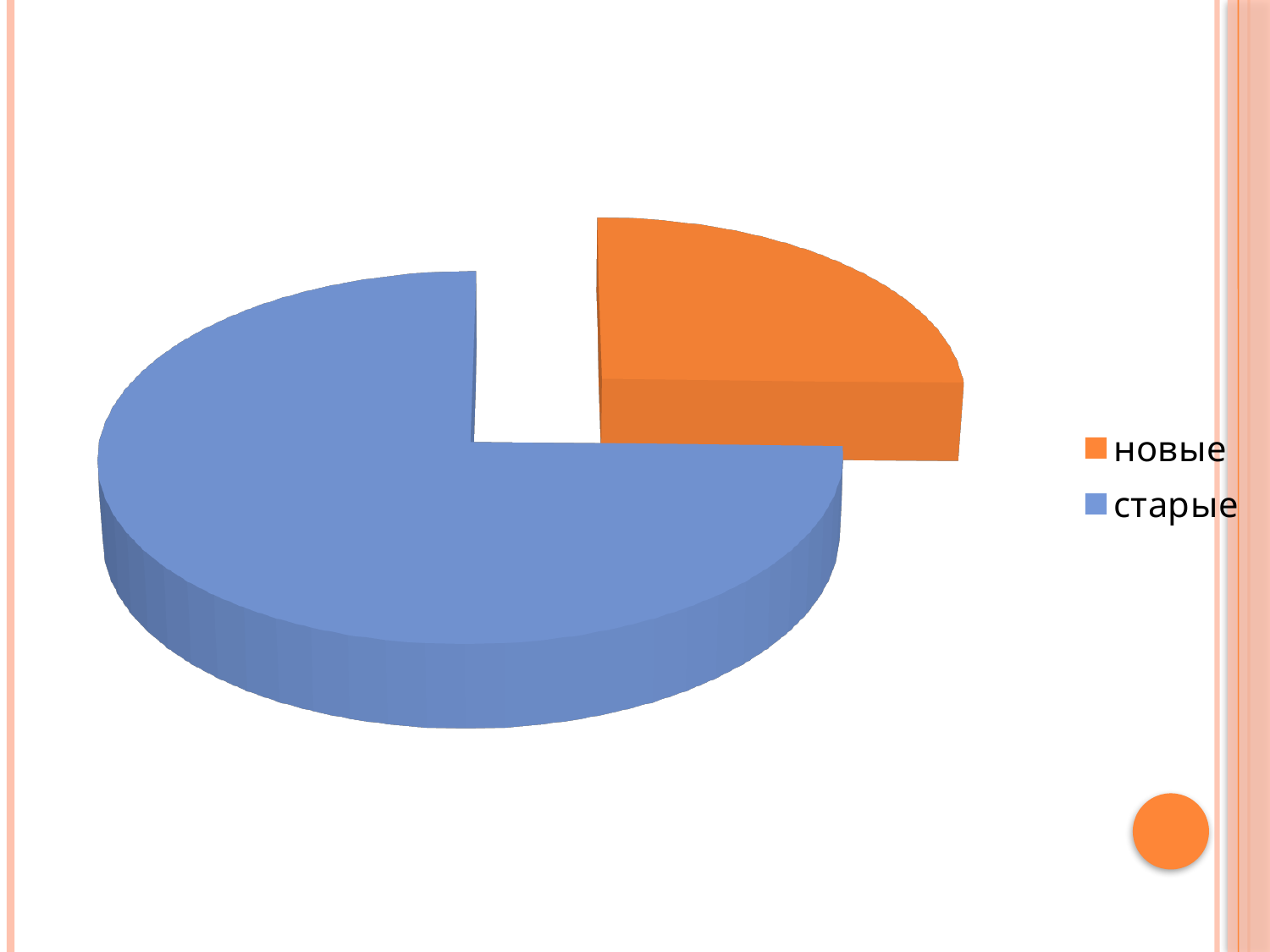
Which slice is larger, новые or старые? старые Which category has the largest slice of the pie? старые What kind of chart is shown on the slide? pie chart How many slices does the pie chart have? 2 How many entries does the legend list? 2 What colour is the slice for новые? orange Which category has the smallest slice of the pie? новые What colour is the slice for старые? blue